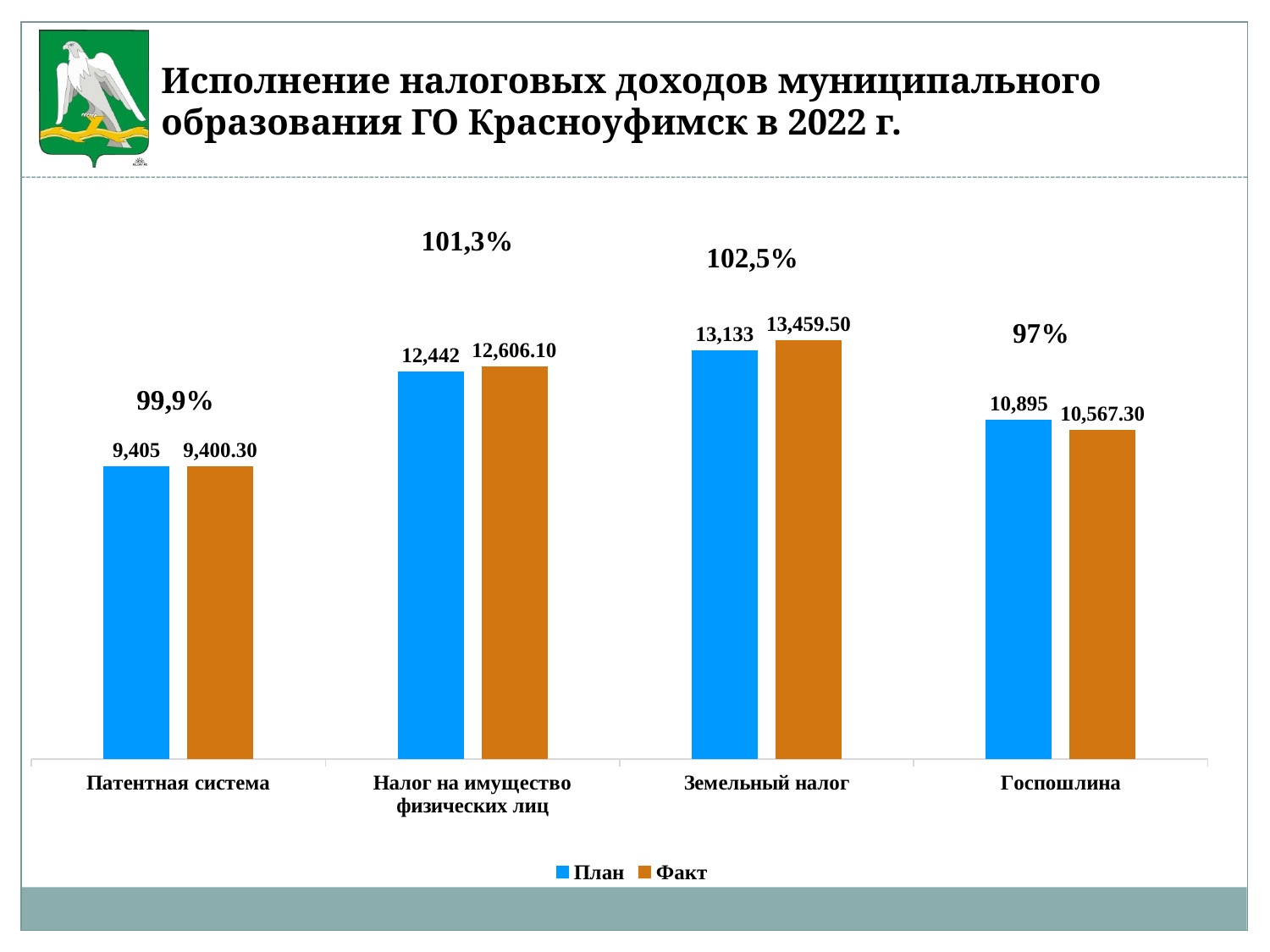
What percentage is printed above the bars for Земельный налог? 102,5% How many series does the chart legend list? 2 What is the difference between the Факт and План values for Земельный налог? 326.50 How many categories are shown on the x axis of the chart? 4 What is the Факт value for Госпошлина? 10,567.30 Which category has the lowest План value? Патентная система What type of chart is shown on the slide? bar chart For Госпошлина, which is larger: the План value or the Факт value? План What is the Факт value for Налог на имущество физических лиц? 12,606.10 Which category has the highest Факт value? Земельный налог What is the План value for Земельный налог? 13,133 What is the План value for Патентная система? 9,405